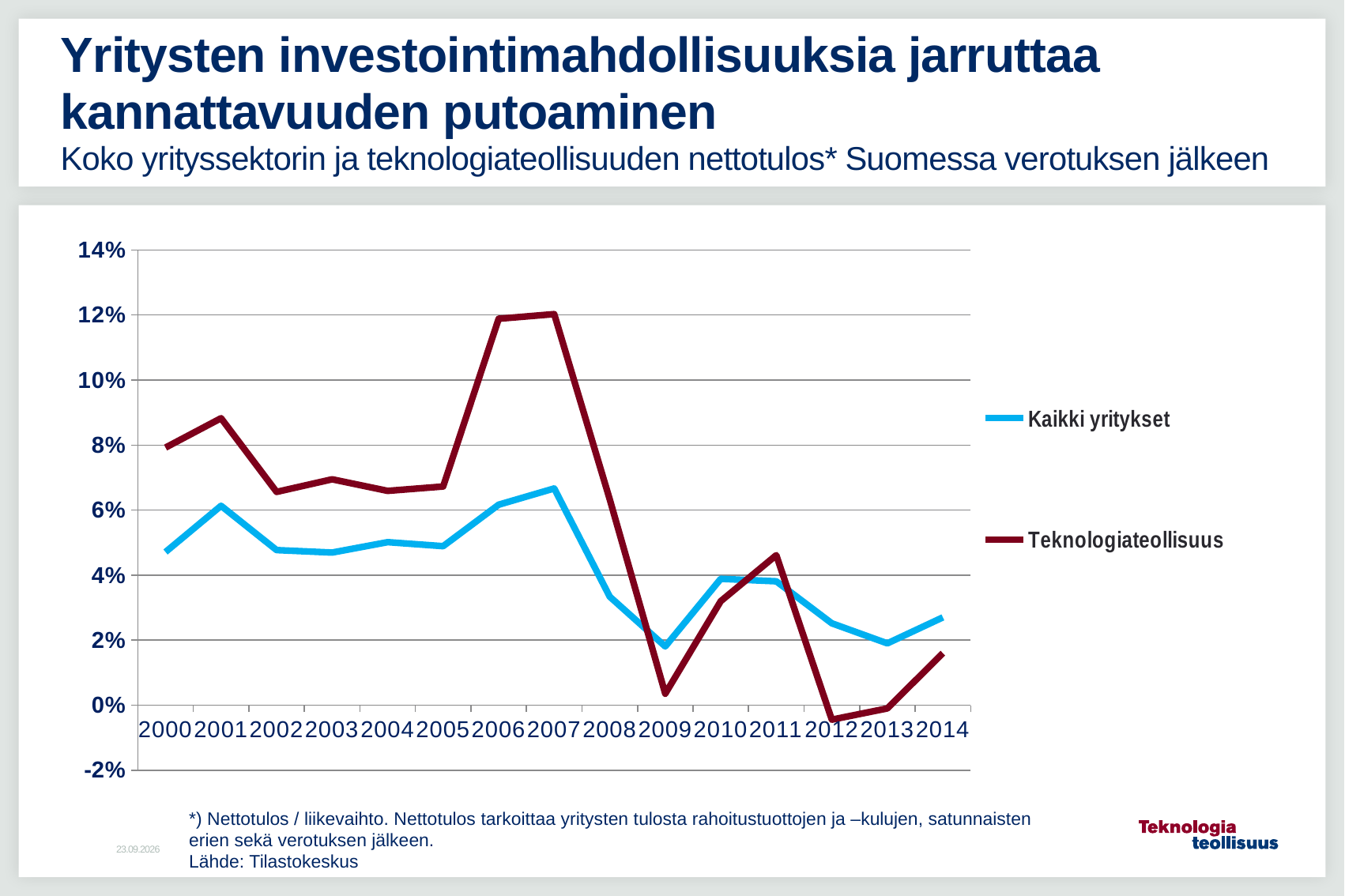
Is the value for Teknologiateollisuus in 2006 greater or less than 10%? greater In 2000, which series has the higher value, Kaikki yritykset or Teknologiateollisuus? Teknologiateollisuus How many years are plotted along the x axis? 15 Which colour is used for the Teknologiateollisuus line? dark red Does the Kaikki yritykset series rise or fall from 2007 to 2009? fall In 2009, which series has the higher value, Kaikki yritykset or Teknologiateollisuus? Kaikki yritykset Is the value for Teknologiateollisuus in 2009 greater or less than 2%? less How many series does the legend list? 2 What kind of chart is shown on the slide? line chart In which year does the Kaikki yritykset series reach its highest value? 2007 Is the value for Teknologiateollisuus in 2012 greater or less than 0%? less